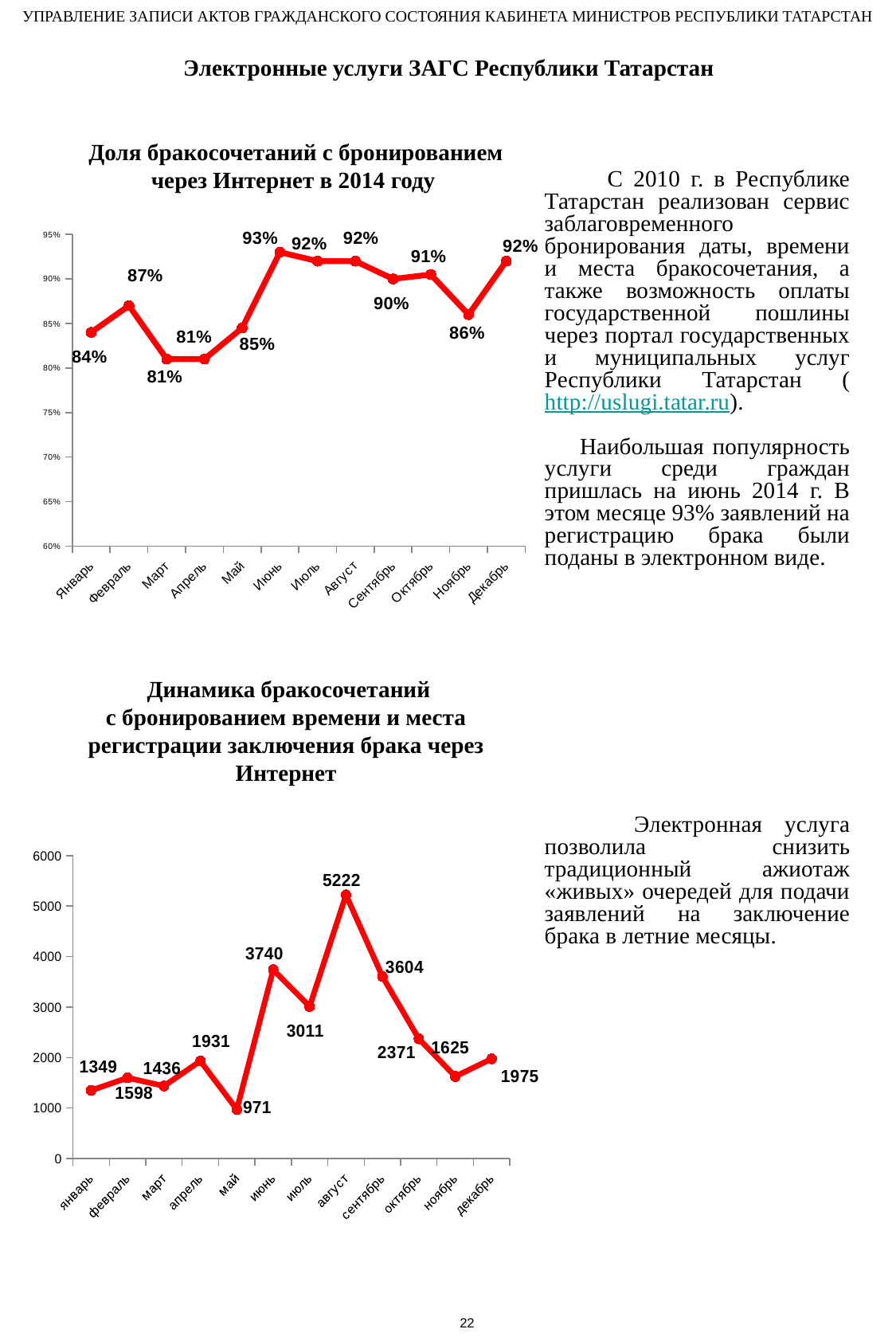
In the chart 'Доля бракосочетаний с бронированием через Интернет в 2014 году', which month has the highest value? Июнь In the chart 'Доля бракосочетаний с бронированием через Интернет в 2014 году', what is the difference between the values for Июнь and Январь? 9% In the chart 'Динамика бракосочетаний с бронированием времени и места регистрации заключения брака через Интернет', which is larger, the value for июнь or the value for сентябрь? июнь In the chart 'Динамика бракосочетаний с бронированием времени и места регистрации заключения брака через Интернет', what is the difference between the values for август and июль? 2211 In the chart 'Доля бракосочетаний с бронированием через Интернет в 2014 году', what is the value for Ноябрь? 86% In the chart 'Доля бракосочетаний с бронированием через Интернет в 2014 году', what is the value for Июнь? 93% In the chart 'Динамика бракосочетаний с бронированием времени и места регистрации заключения брака через Интернет', which month has the lowest value? май In the chart 'Динамика бракосочетаний с бронированием времени и места регистрации заключения брака через Интернет', what is the value for май? 971 In the chart 'Доля бракосочетаний с бронированием через Интернет в 2014 году', how many months are plotted? 12 In the chart 'Динамика бракосочетаний с бронированием времени и места регистрации заключения брака через Интернет', what is the value for август? 5222 In the chart 'Динамика бракосочетаний с бронированием времени и места регистрации заключения брака через Интернет', do the values rise or fall from август to ноябрь? Fall What kind of chart is 'Доля бракосочетаний с бронированием через Интернет в 2014 году'? Line chart